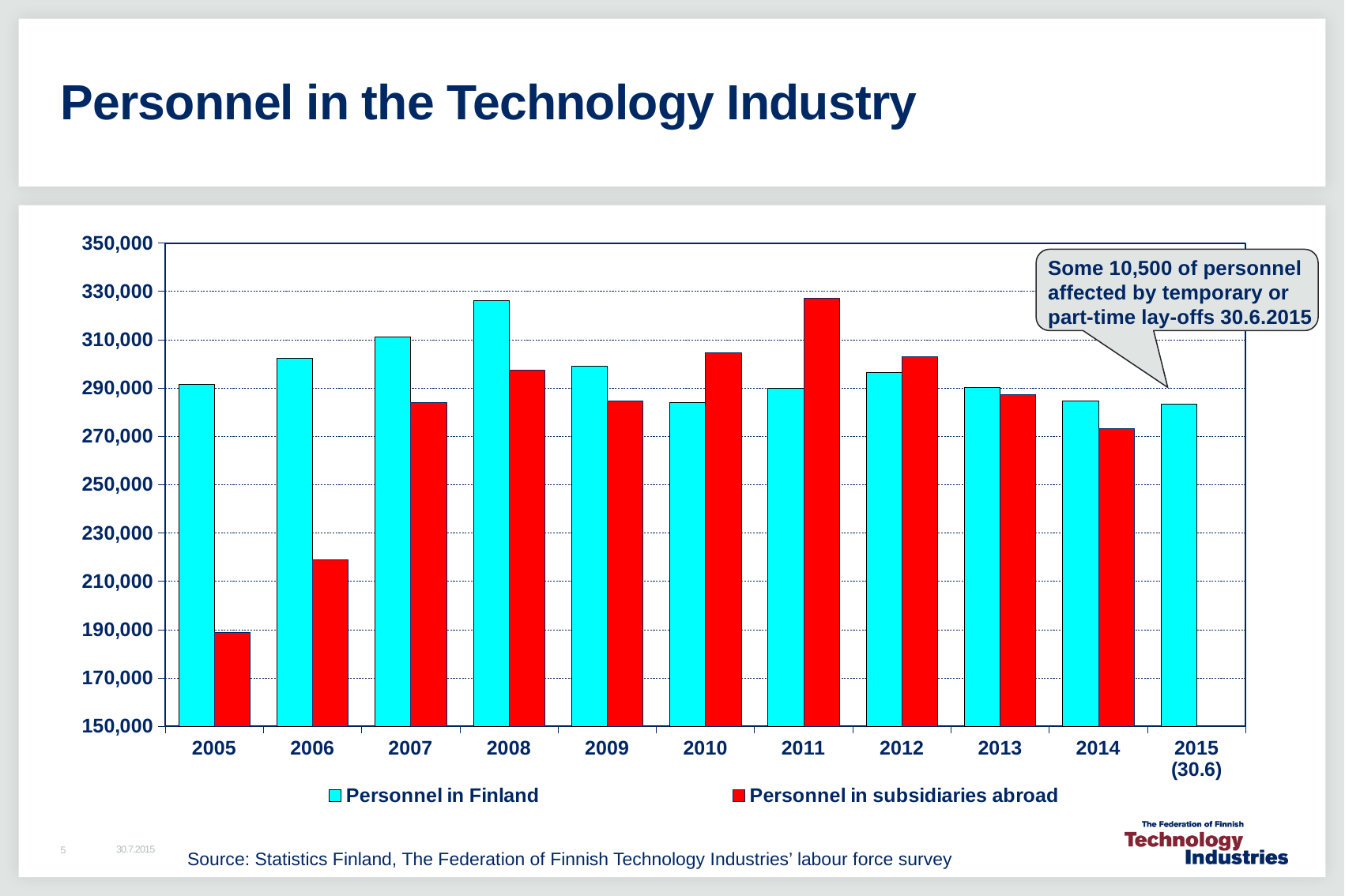
How many years (categories) are shown on the x axis? 11 In which year is Personnel in subsidiaries abroad lowest? 2005 How many series does the legend list? 2 In 2010, which is larger: Personnel in Finland or Personnel in subsidiaries abroad? Personnel in subsidiaries abroad Is the value for Personnel in Finland in 2008 greater or less than 310,000? greater Does Personnel in subsidiaries abroad rise or fall from 2005 to 2008? rise In 2014, which is larger: Personnel in Finland or Personnel in subsidiaries abroad? Personnel in Finland What kind of chart is shown on the slide? bar chart In which year is Personnel in subsidiaries abroad highest? 2011 Which series is shown in red? Personnel in subsidiaries abroad Is the value for Personnel in subsidiaries abroad in 2005 greater or less than 210,000? less In which year is Personnel in Finland highest? 2008